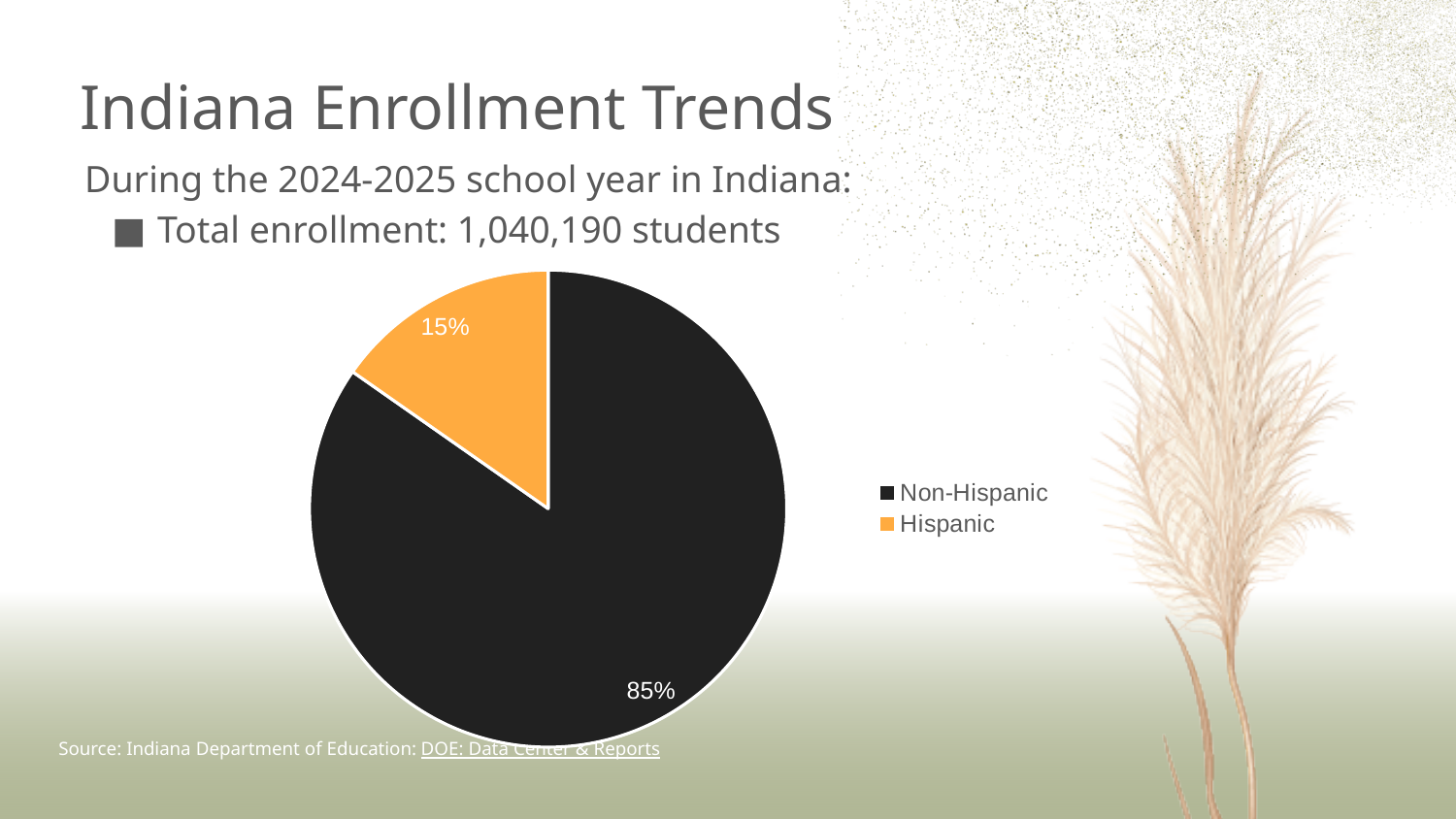
What is the title of the slide containing the pie chart? Indiana Enrollment Trends What share of the pie does the Hispanic slice represent? 15% How many categories does the pie chart show? 2 What colour is the Hispanic slice in the pie chart? orange What is the difference in percentage points between the Non-Hispanic and Hispanic slices? 70 Which category has the largest slice of the pie? Non-Hispanic What kind of chart is shown on the slide? pie chart Which slice is larger, Hispanic or Non-Hispanic? Non-Hispanic Which category has the smallest slice of the pie? Hispanic How many entries does the legend list? 2 What share of the pie does the Non-Hispanic slice represent? 85%